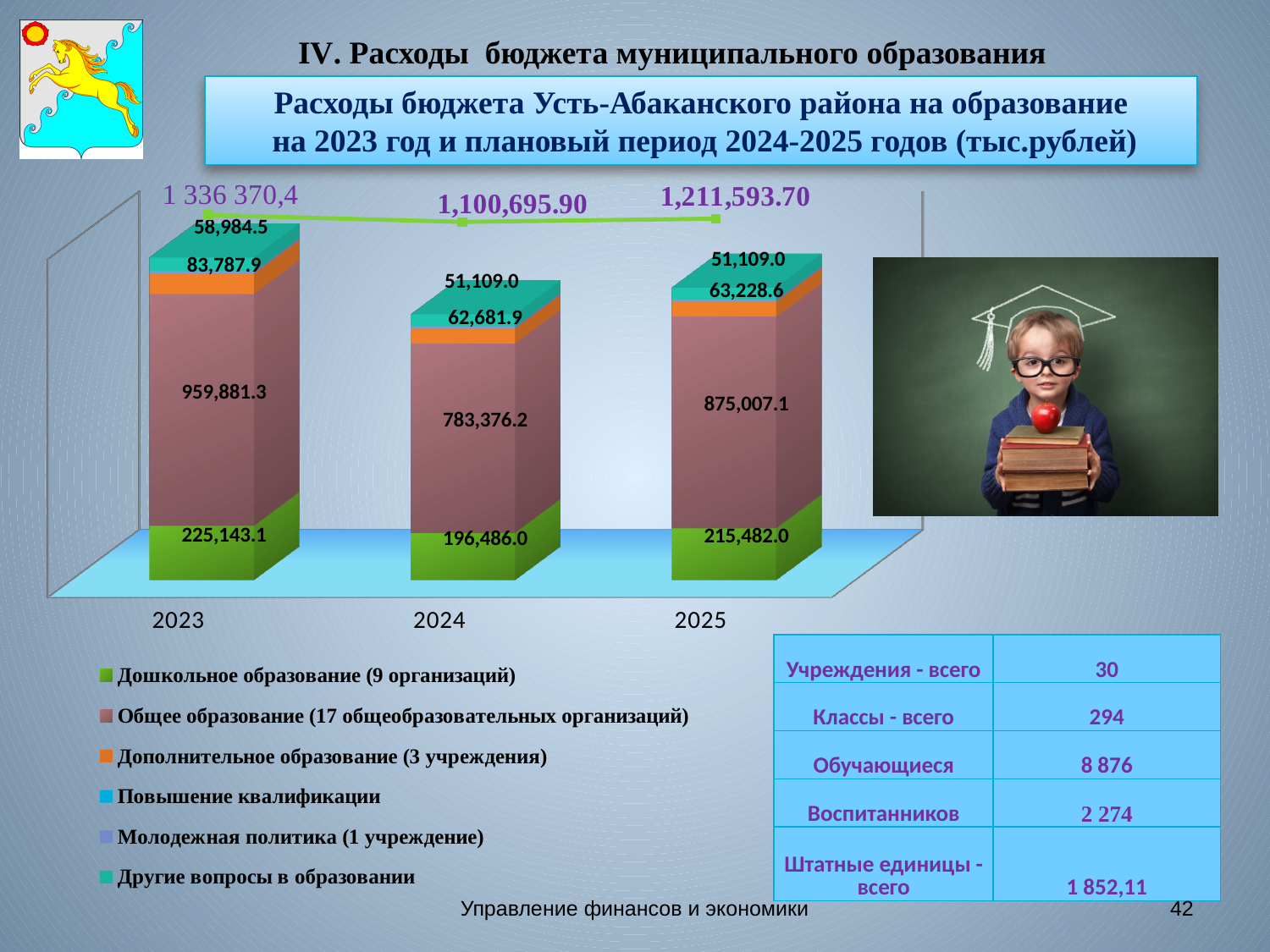
What is the total shown above the bar for 2024? 1,100,695.90 What is the value for Дошкольное образование in 2024? 196,486.0 How many years (categories) are shown on the x axis of the chart? 3 What is the value for Дополнительное образование in 2025? 63,228.6 Which year has the larger value for Дополнительное образование, 2023 or 2024? 2023 How many series does the chart legend list? 6 In which year is the value for Общее образование the highest? 2023 What kind of chart is shown on the slide? Stacked bar chart What is the value for Общее образование in 2023? 959,881.3 What is the title of the chart? Расходы бюджета Усть-Абаканского района на образование на 2023 год и плановый период 2024-2025 годов (тыс.рублей) In which year is the value for Дошкольное образование the lowest? 2024 What is the difference between the Общее образование values for 2025 and 2024? 91,630.9